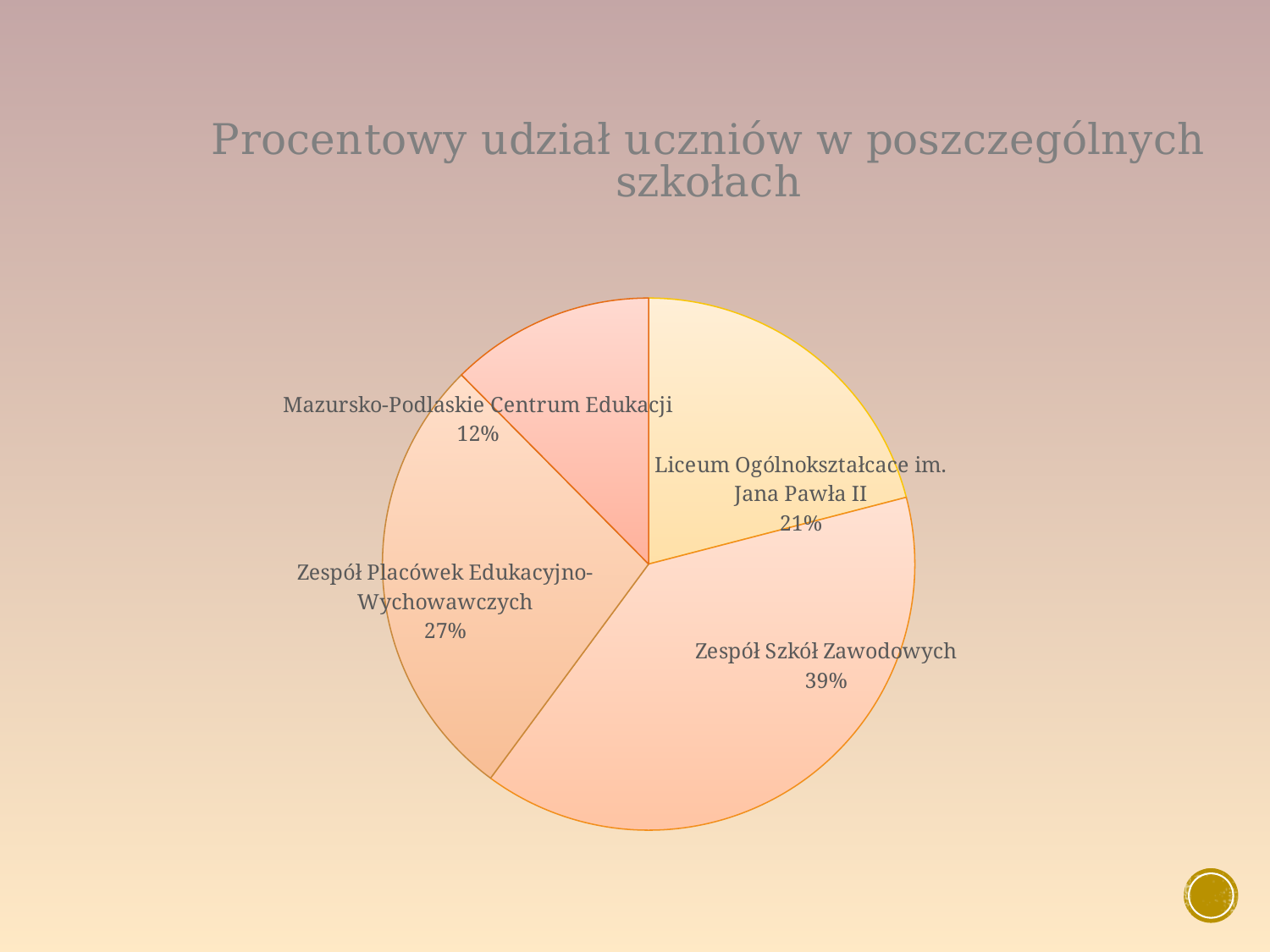
Which has a larger share: Liceum Ogólnokształcące im. Jana Pawła II or Zespół Placówek Edukacyjno-Wychowawczych? Zespół Placówek Edukacyjno-Wychowawczych How many slices does the pie chart have? 4 Which school has the smallest share of students? Mazursko-Podlaskie Centrum Edukacji What share of the pie does Mazursko-Podlaskie Centrum Edukacji have? 12% What kind of chart is shown on the slide? pie chart What is the title of the slide? Procentowy udział uczniów w poszczególnych szkołach What share of the pie does Liceum Ogólnokształcące im. Jana Pawła II have? 21% What share of the pie does Zespół Szkół Zawodowych have? 39% What is the difference in percentage points between Liceum Ogólnokształcące im. Jana Pawła II and Mazursko-Podlaskie Centrum Edukacji? 9 What is the difference in percentage points between Zespół Szkół Zawodowych and Zespół Placówek Edukacyjno-Wychowawczych? 12 Which school has the largest share of students? Zespół Szkół Zawodowych